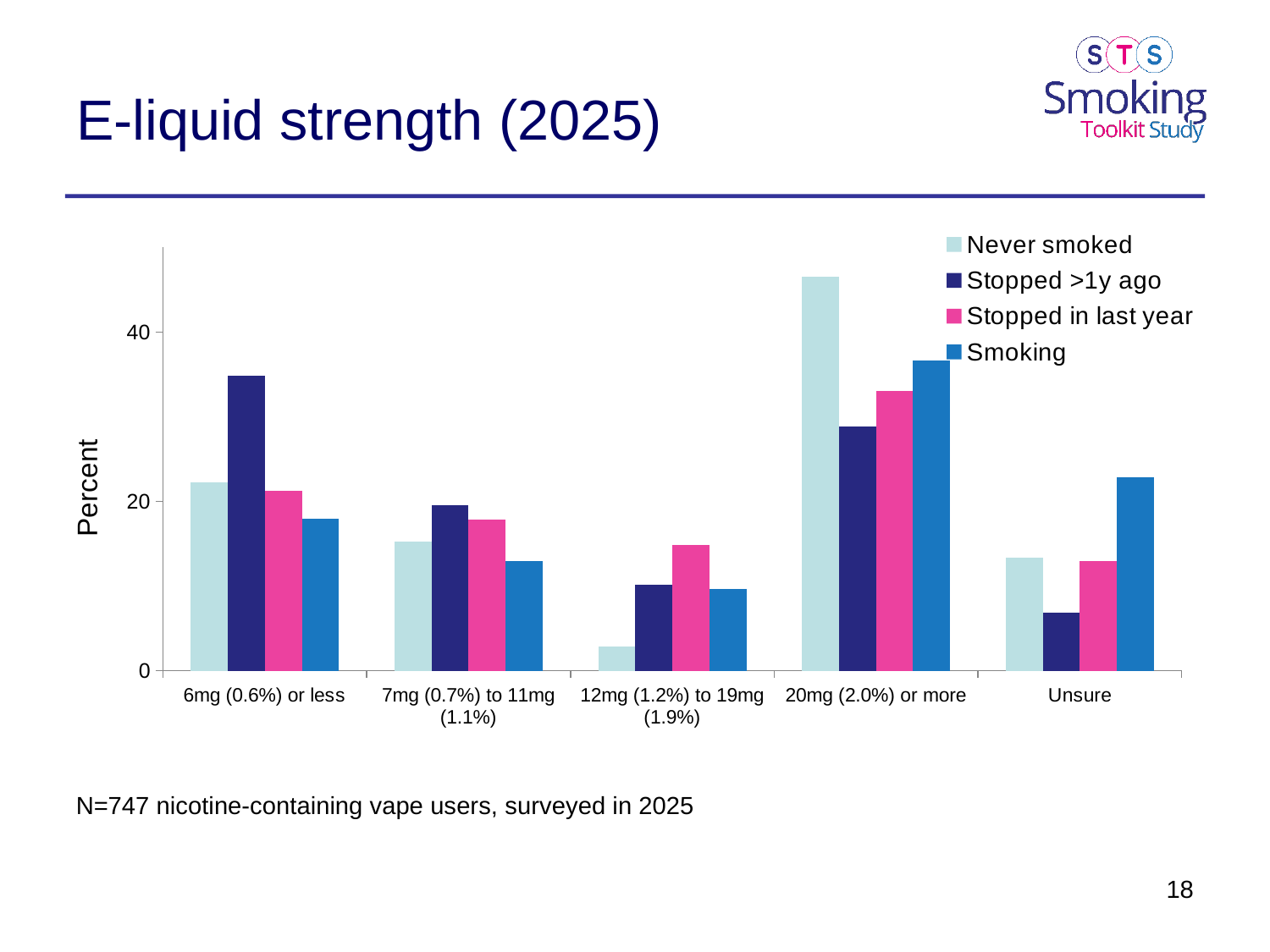
Is the value for Never smoked at 20mg (2.0%) or more greater or less than 40? greater Is the value for Stopped >1y ago at 6mg (0.6%) or less greater or less than 20? greater For the Never smoked series, which category has the lowest bar? 12mg (1.2%) to 19mg (1.9%) What kind of chart is shown on the slide? bar chart At 6mg (0.6%) or less, which is larger: Stopped >1y ago or Smoking? Stopped >1y ago What is the label on the y axis? Percent Is the value for Smoking at 20mg (2.0%) or more greater or less than 20? greater How many e-liquid strength categories are shown on the x axis? 5 How many series does the legend list? 4 In the Unsure category, which series has the highest bar? Smoking For the Never smoked series, which category has the highest bar? 20mg (2.0%) or more